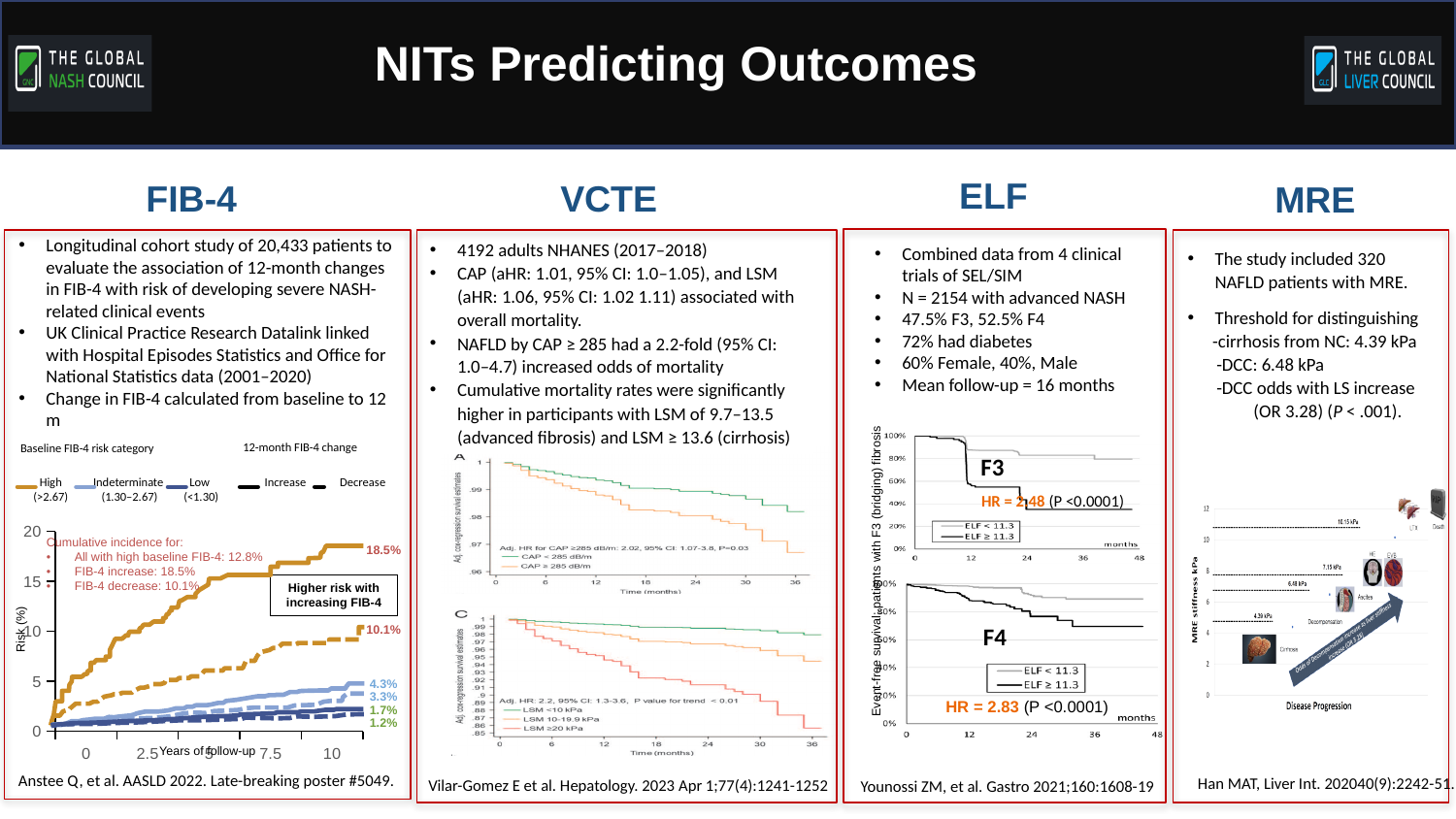
On the FIB-4 chart, is the risk for the high-baseline increase line at 10 years greater or less than 15? greater On the FIB-4 chart, which is larger: the end-of-follow-up risk for the indeterminate-baseline increase line or the low-baseline increase line? Indeterminate-baseline increase (4.3%) On the FIB-4 chart, what is the cumulative incidence at the end of follow-up for patients with high baseline FIB-4 whose FIB-4 increased? 18.5% On the MRE chart, what is the MRE stiffness threshold shown for cirrhosis? 4.39 kPa On the ELF F4 chart, what is the hazard ratio shown? HR = 2.83 On the FIB-4 chart, what is the cumulative incidence at the end of follow-up for patients with high baseline FIB-4 whose FIB-4 decreased? 10.1% On the FIB-4 chart, how many baseline FIB-4 risk categories does the legend list? 3 On the FIB-4 chart, what is the difference between the end-of-follow-up risk for the high-baseline increase line (18.5%) and the high-baseline decrease line (10.1%)? 8.4 percentage points What kind of chart is the FIB-4 chart? Line chart On the FIB-4 chart, which line ends with the lowest risk value? Low baseline FIB-4 with decrease (1.2%) On the ELF charts, which has the larger hazard ratio: F3 or F4? F4 (2.83) On the FIB-4 chart, do the risk values rise or fall as years of follow-up increase? Rise